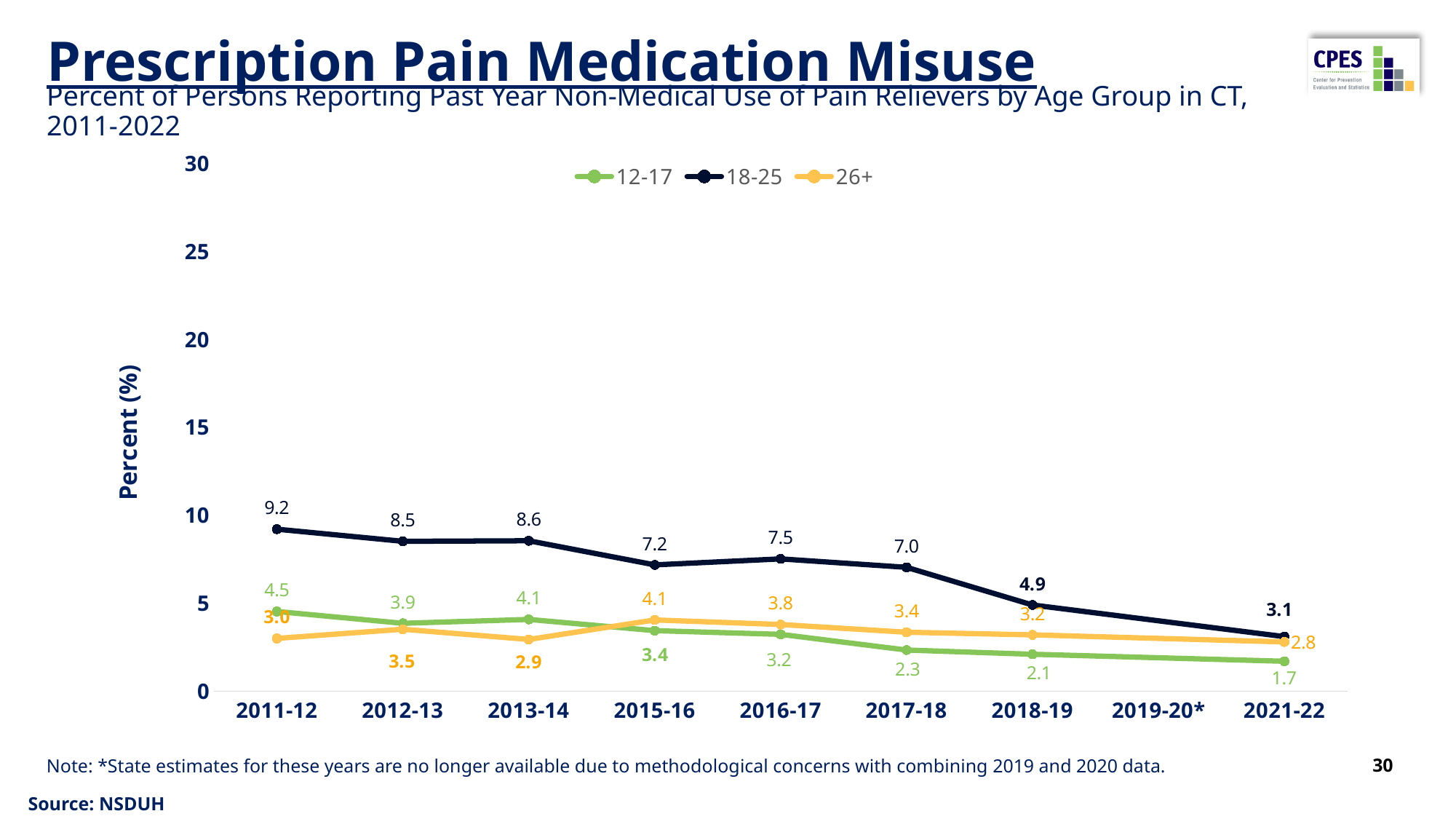
Does the 18-25 line generally rise or fall from 2011-12 to 2021-22? fall What was the percent of persons aged 18-25 reporting past year non-medical use of pain relievers in 2011-12? 9.2 Is the 18-25 value in 2011-12 greater or less than 10? less Which age group had the highest percent in 2011-12? 18-25 What value is shown for the 12-17 age group in 2021-22? 1.7 In 2012-13, which was larger: the value for 12-17 or the value for 26+? 12-17 How many age groups does the legend list? 3 What value is shown for the 26+ age group in 2015-16? 4.1 What is the title of the y axis? Percent (%) What kind of chart is shown on the slide? line chart By how much did the 18-25 value decrease from 2011-12 to 2021-22? 6.1 In which year did the 12-17 age group have its lowest value? 2021-22